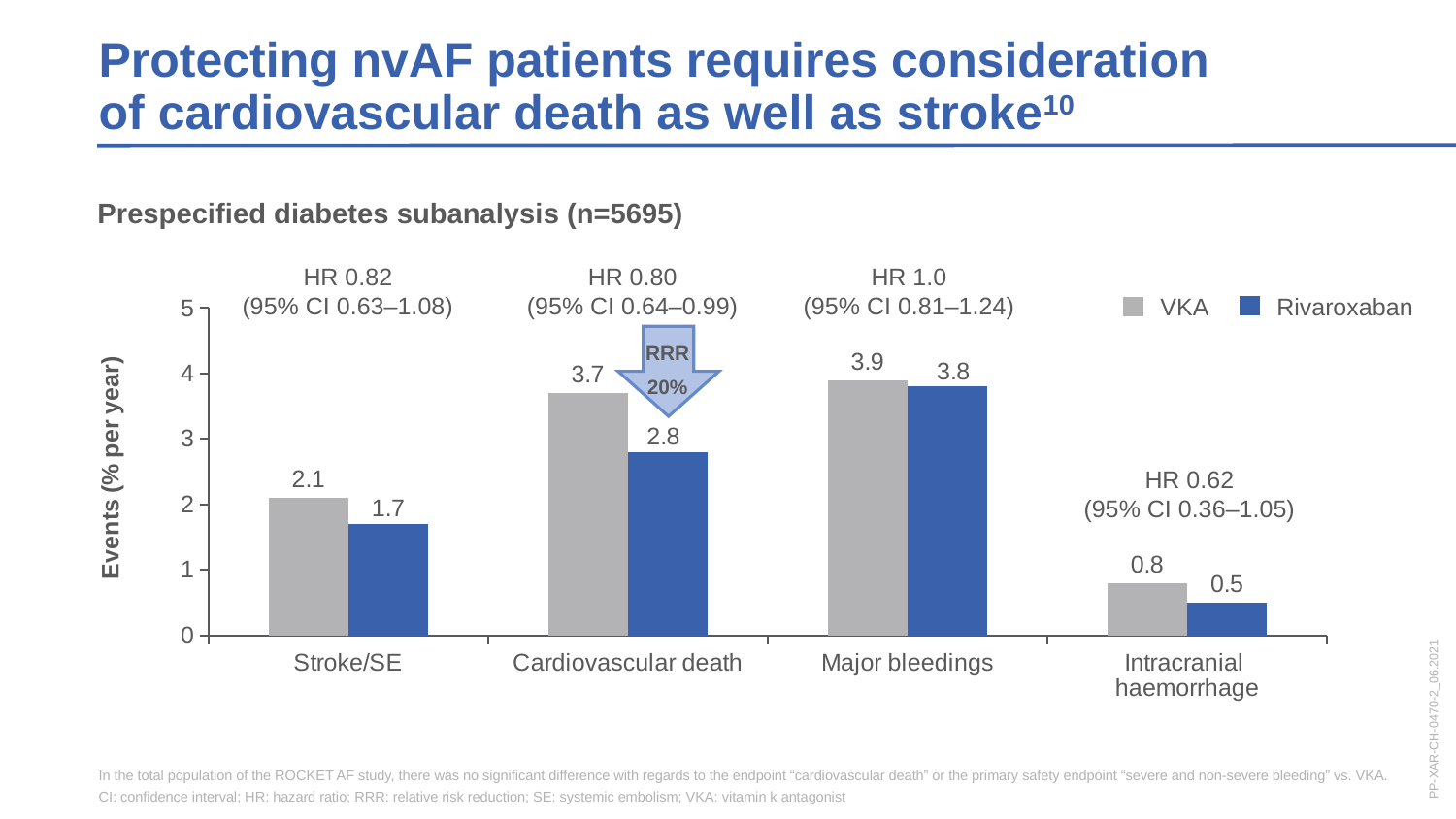
What is the Rivaroxaban value for Intracranial haemorrhage? 0.5 Is the VKA value for Major bleedings greater or less than 3? greater How many categories are shown on the x axis? 4 What kind of chart is shown on the slide? bar chart What is the Rivaroxaban value for Stroke/SE? 1.7 Which category has the lowest Rivaroxaban value? Intracranial haemorrhage Which is larger for Stroke/SE, the VKA value or the Rivaroxaban value? VKA What is the difference between the VKA and Rivaroxaban values for Cardiovascular death? 0.9 What is the VKA value for Cardiovascular death? 3.7 Which category has the highest VKA value? Major bleedings How many series does the legend list? 2 What is the y-axis label of the chart? Events (% per year)